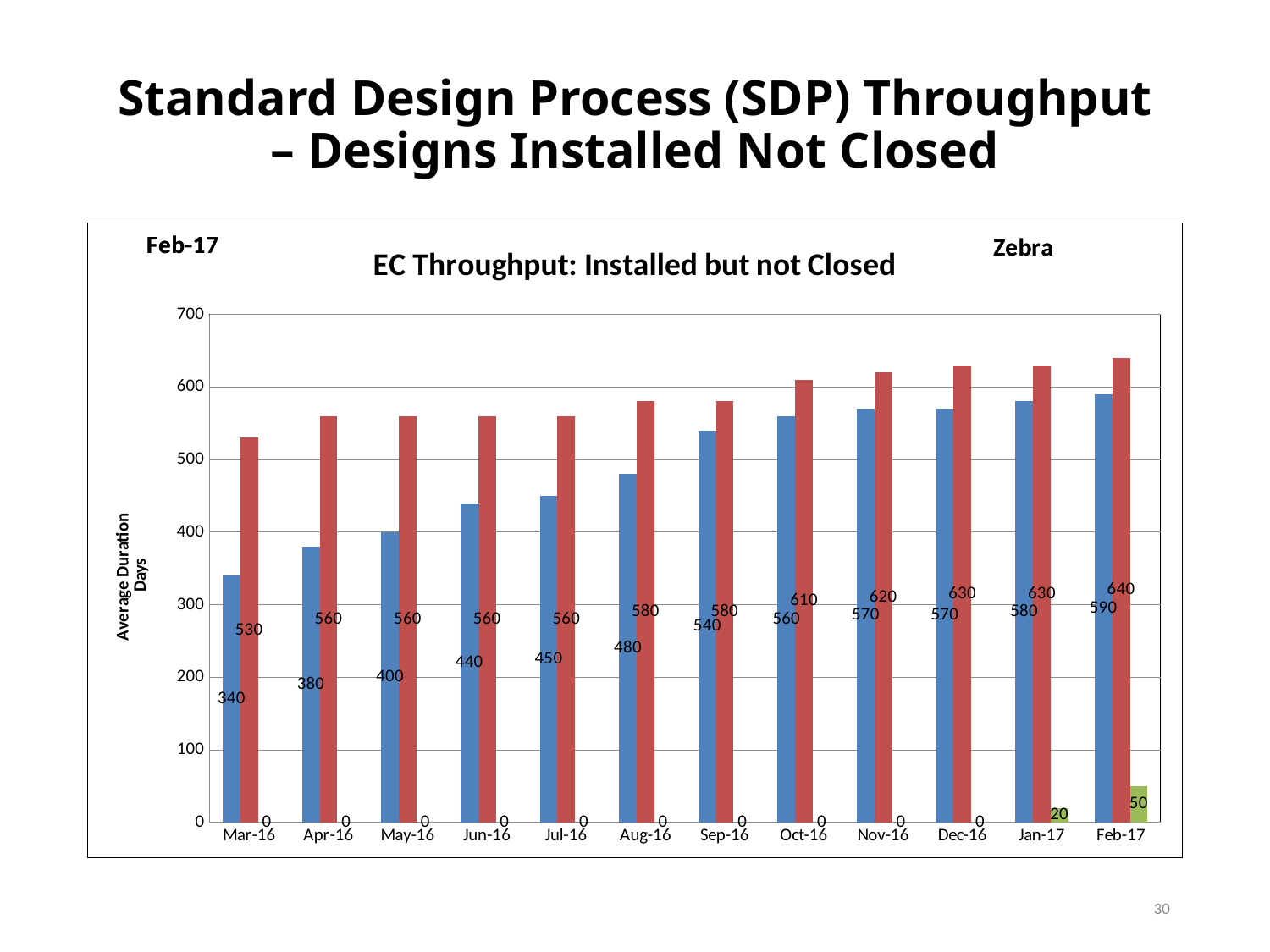
Which month has the highest blue bar? Feb-17 What is the difference between the red bar and the blue bar for Mar-16? 190 How many months are shown on the x axis? 12 Which is larger for Oct-16, the blue bar or the red bar? the red bar What is the value of the blue bar for Sep-16? 540 Which month has the lowest red bar? Mar-16 Do the blue bars rise or fall from Mar-16 to Feb-17? rise What is the difference between the blue bar for Feb-17 and the blue bar for Mar-16? 250 What is the value of the green bar for Jan-17? 20 What type of chart is shown? bar chart What is the value of the blue bar for Mar-16? 340 What is the value of the red bar for Feb-17? 640